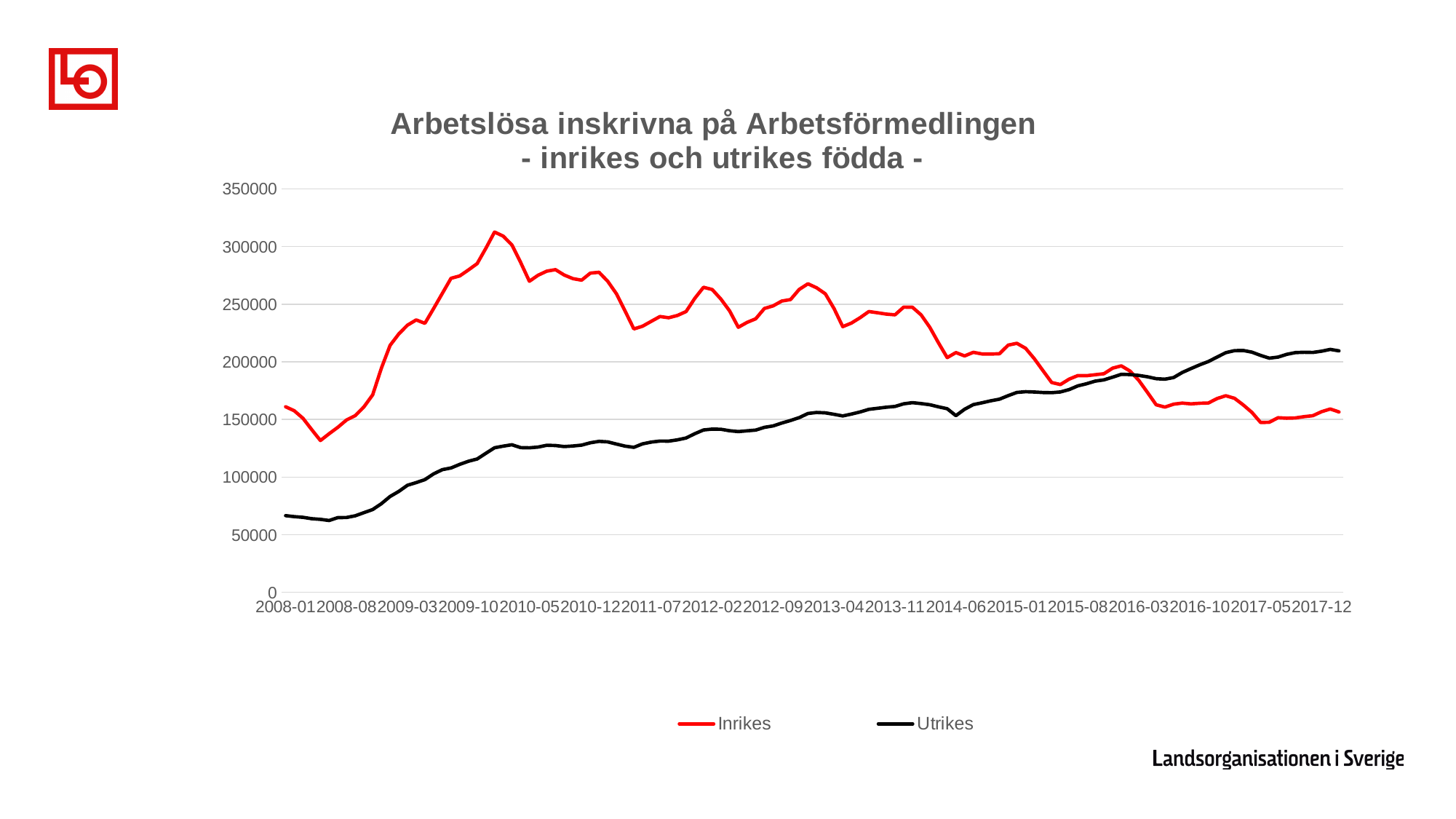
Does the Utrikes series overall rise or fall from 2008-01 to 2017-12? rise Which colour is used for the Utrikes series? black At 2017-12, which series has the larger value, Inrikes or Utrikes? Utrikes At 2008-01, which series has the larger value, Inrikes or Utrikes? Inrikes Is the value for Utrikes at 2008-01 greater or less than 100000? less Is the value for Inrikes at 2014-06 greater or less than 250000? less What kind of chart is shown on the slide? line chart What is the title of the chart? Arbetslösa inskrivna på Arbetsförmedlingen - inrikes och utrikes födda - Is the value for Utrikes at 2012-02 greater or less than 100000? greater How many series does the legend list? 2 Does the Inrikes series rise or fall from 2009-10 to 2017-12? fall